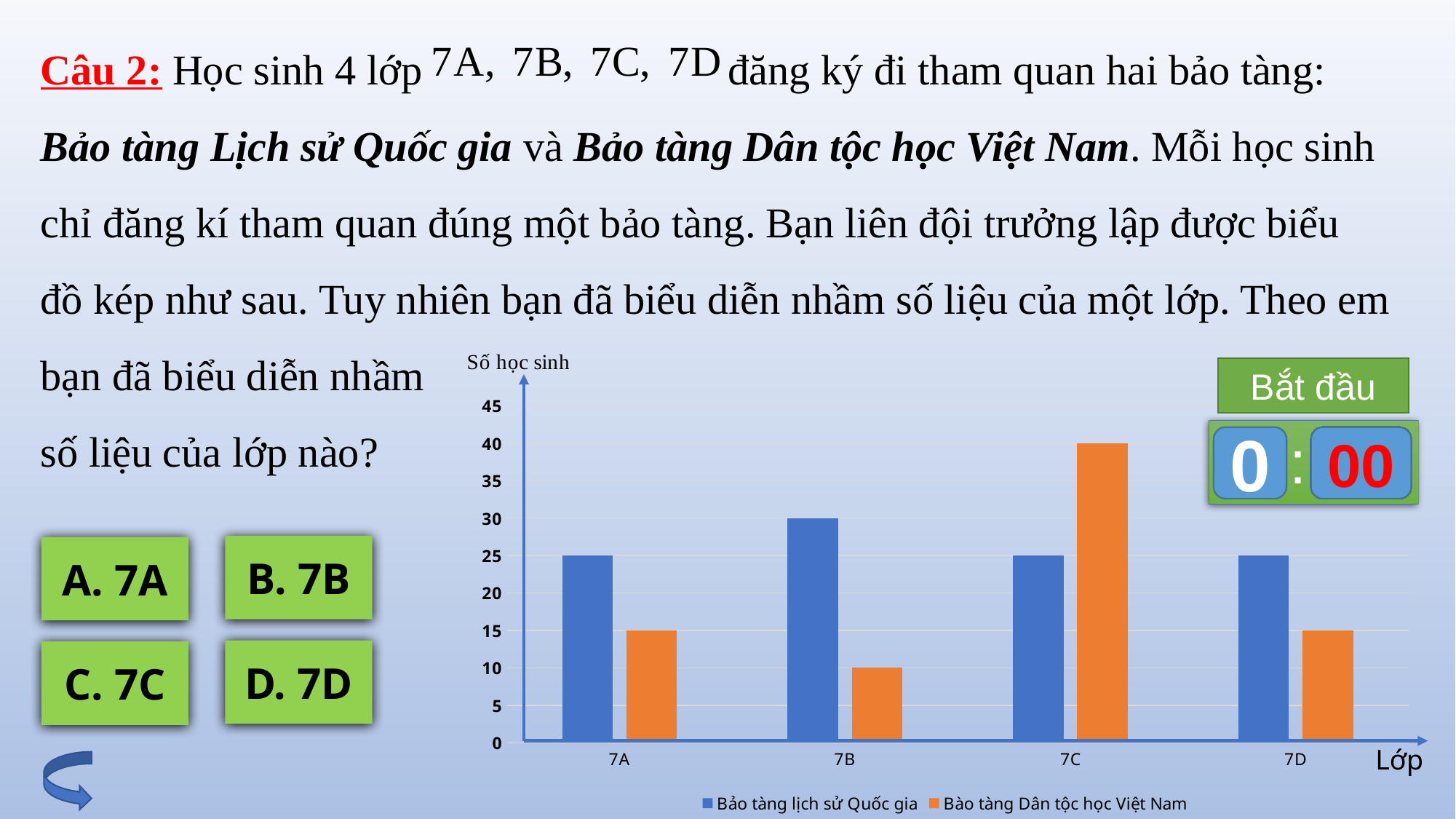
Which class has the highest value in the series Bào tàng Dân tộc học Việt Nam? 7C What is the value for class 7A in the series Bào tàng Dân tộc học Việt Nam? 15 What is the total of the two series values for class 7B? 40 What is the label on the vertical axis of the chart? Số học sinh What is the value for class 7B in the series Bảo tàng lịch sử Quốc gia? 30 What is the difference between the two series values for class 7C? 15 What kind of chart is shown on the slide? bar chart How many series does the chart legend list? 2 How many classes are shown on the x axis of the chart? 4 Which class has the lowest value in the series Bào tàng Dân tộc học Việt Nam? 7B What is the value for class 7C in the series Bào tàng Dân tộc học Việt Nam? 40 For class 7D, which series has the larger value? Bảo tàng lịch sử Quốc gia